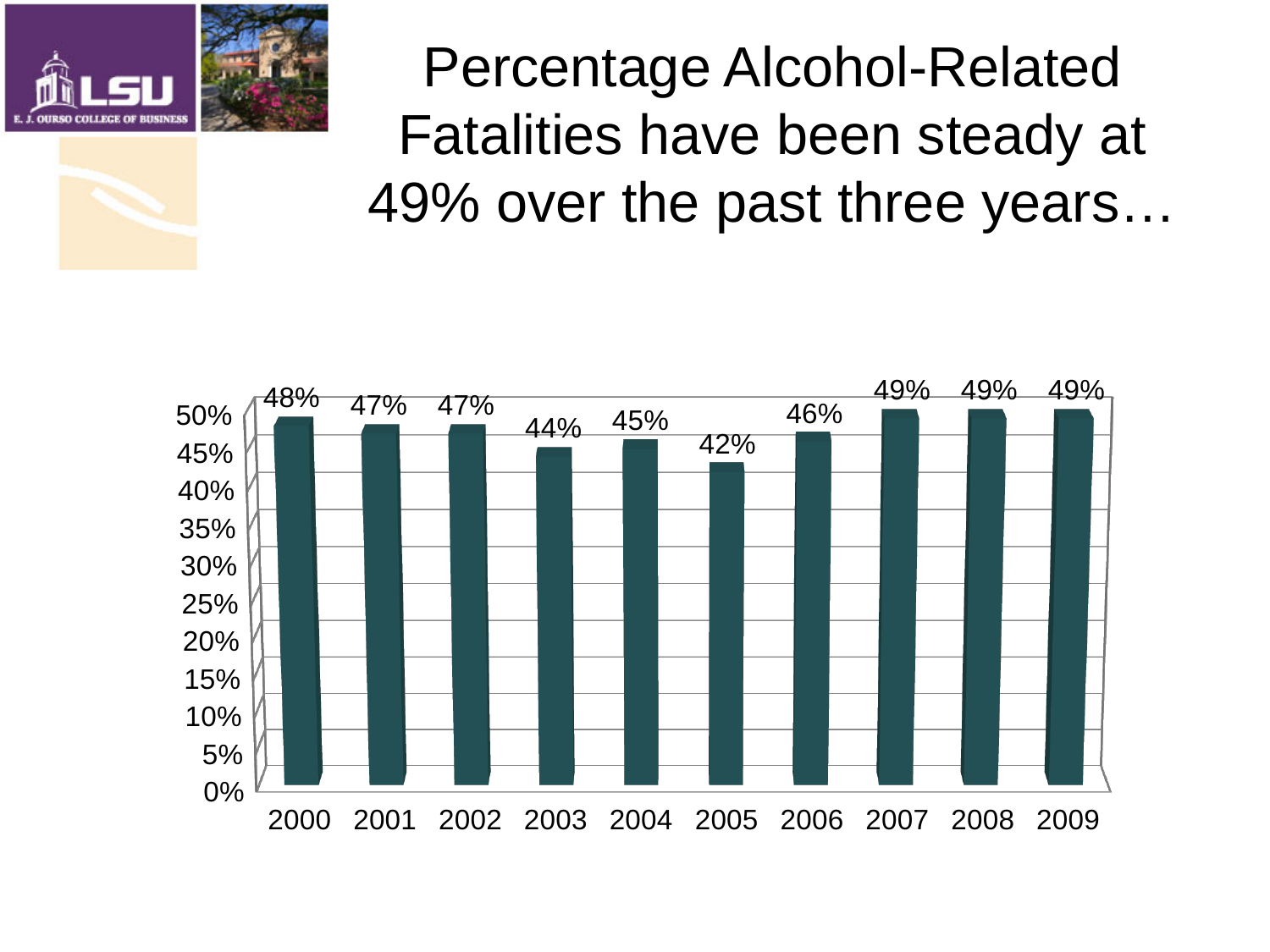
Is the value for 2004 greater or less than 40%? greater Which year has the lowest value? 2005 Do the values rise or fall from 2005 to 2007? rise What is the difference between the values for 2000 and 2003? 4% What kind of chart is shown on the slide? bar chart What is the highest value shown on the y axis? 50% How many years are shown on the x axis? 10 What is the value for 2005? 42% Which is larger, the value for 2006 or the value for 2005? 2006 What is the difference between the values for 2009 and 2005? 7% What is the value for 2003? 44% What is the value for 2000? 48%